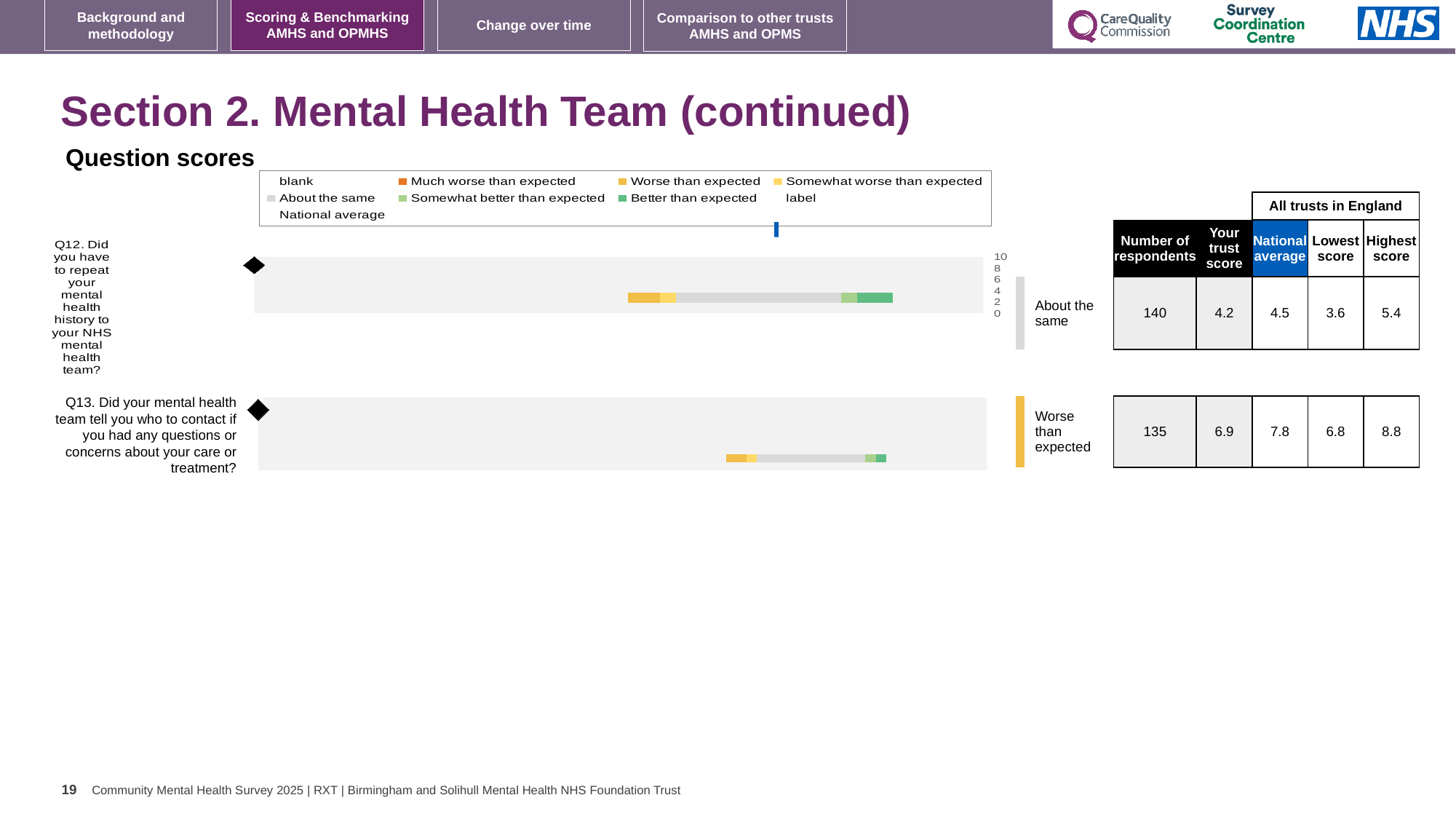
Which question has the higher trust score, Q12 or Q13? Q13 What is the difference between the national average and the trust score for Q12? 0.3 How many respondents answered Q13 (who to contact with questions or concerns)? 135 What is the highest score among all trusts in England for Q13? 8.8 For Q13, which is larger: the trust score or the national average? national average What is the difference between the highest and lowest scores for Q13? 2.0 How many questions are plotted in the question scores charts? 2 What is the national average score for Q12? 4.5 What kind of chart is used to show the question scores for Q12 and Q13? bar chart What is the lowest score among all trusts in England for Q12? 3.6 What benchmark rating is shown next to the Q13 bar? Worse than expected What is the trust score for Q12 (repeating mental health history)? 4.2